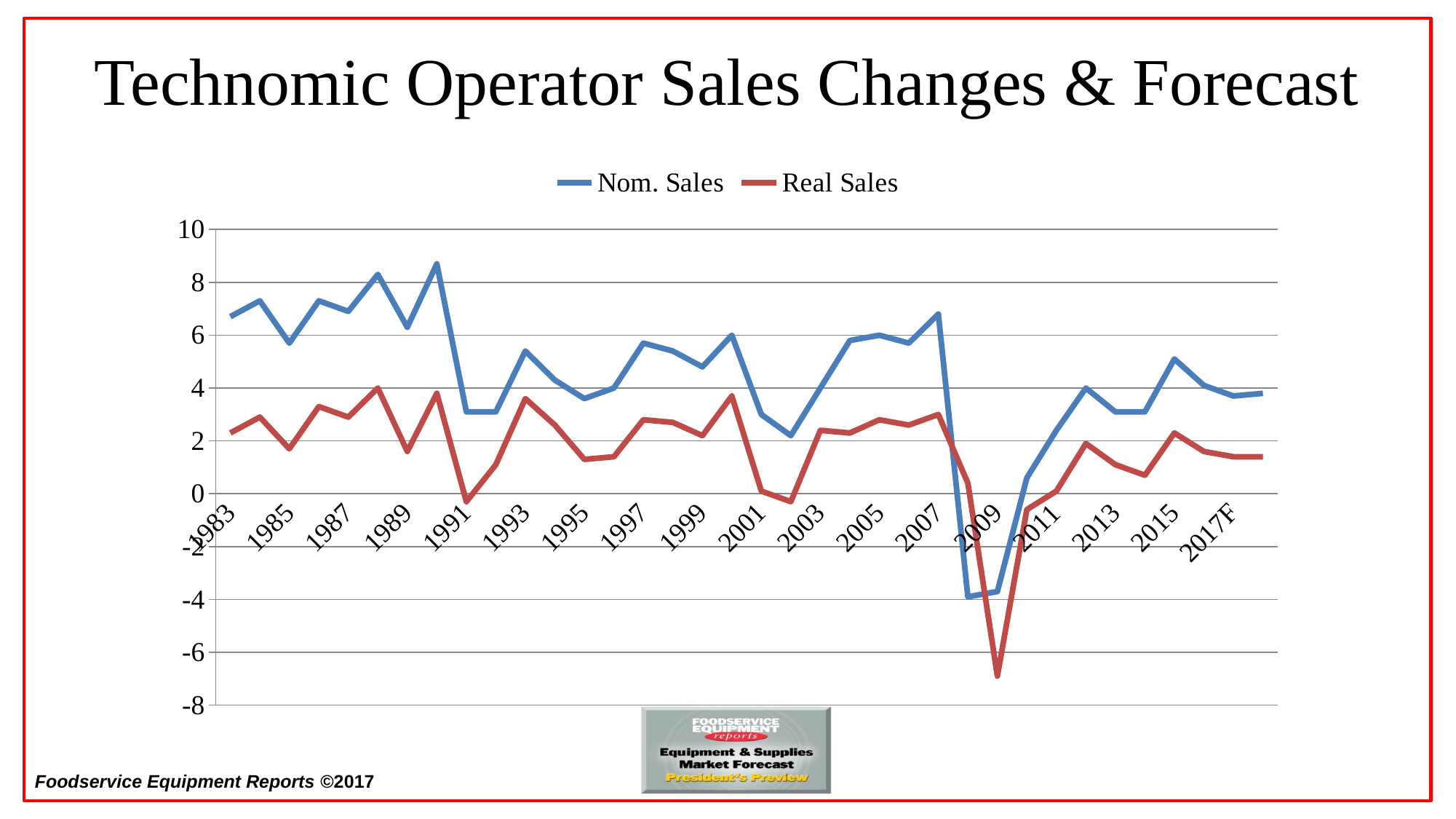
Is the value for Real Sales in 2017F greater or less than 2? less Does Nom. Sales rise or fall from 2007 to 2009? fall Is the value for Real Sales in 2009 greater or less than -6? less What type of chart is shown on the slide? line chart How many series does the legend list? 2 In 2009, which is larger, Nom. Sales or Real Sales? Nom. Sales Is the value for Nom. Sales in 2009 greater or less than -2? less In which year does Real Sales reach its lowest value? 2009 Which series is drawn in red? Real Sales What is the title of the chart? Technomic Operator Sales Changes & Forecast In which year does Nom. Sales reach its highest value? 1990